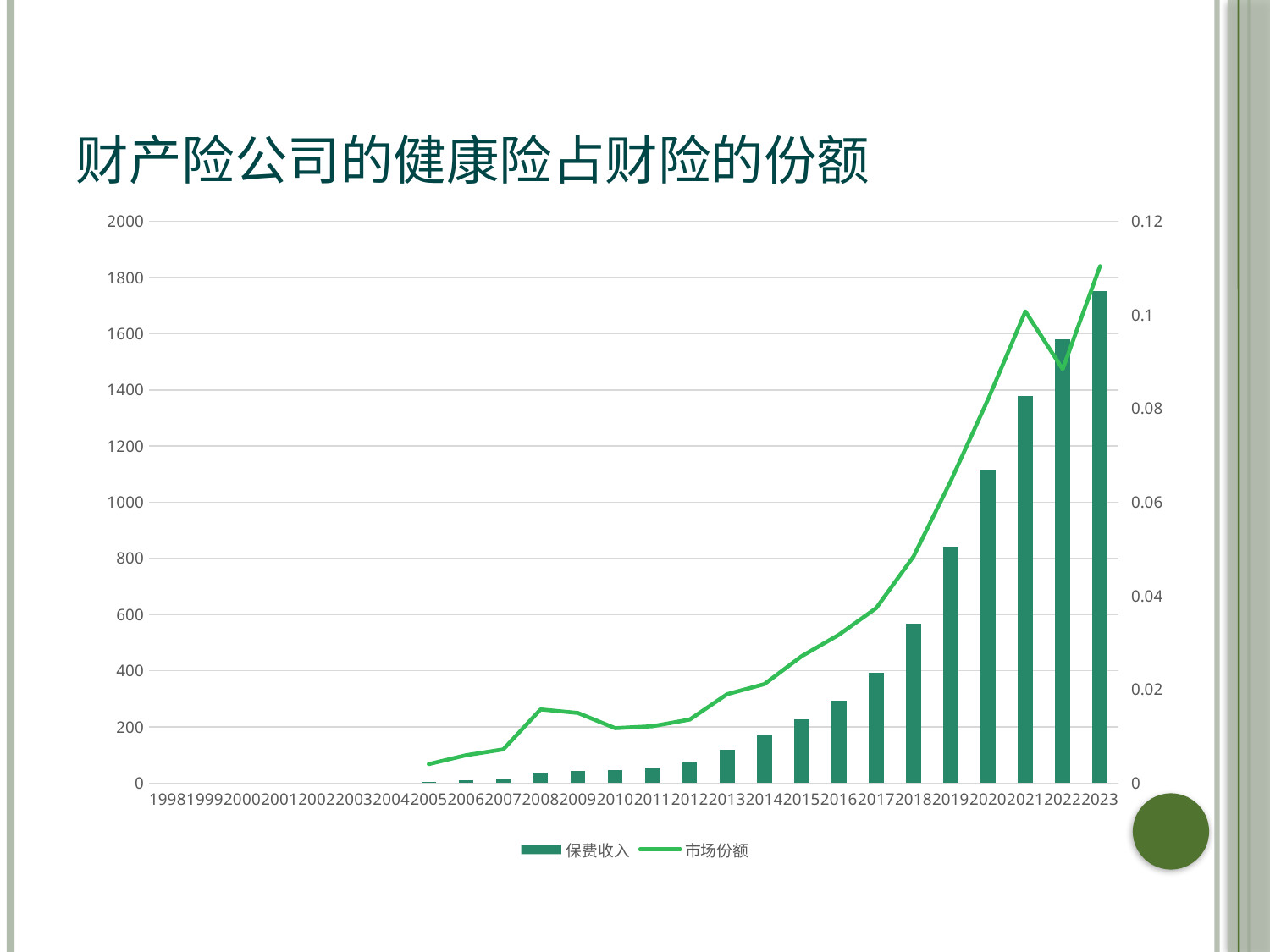
Do the 保费收入 bars generally rise or fall from 2005 to 2023? rise What kind of chart is shown on the slide? A combination bar and line chart How many years are shown on the x axis? 26 Is the 市场份额 value for 2023 greater or less than 0.1? greater Is the 市场份额 value for 2017 greater or less than 0.04? less What is the title of the chart? 财产险公司的健康险占财险的份额 Which year has the highest 保费收入 bar? 2023 How many series does the legend list? 2 Is the 保费收入 value for 2020 greater or less than 1000? greater Which year has the larger 市场份额 value, 2021 or 2022? 2021